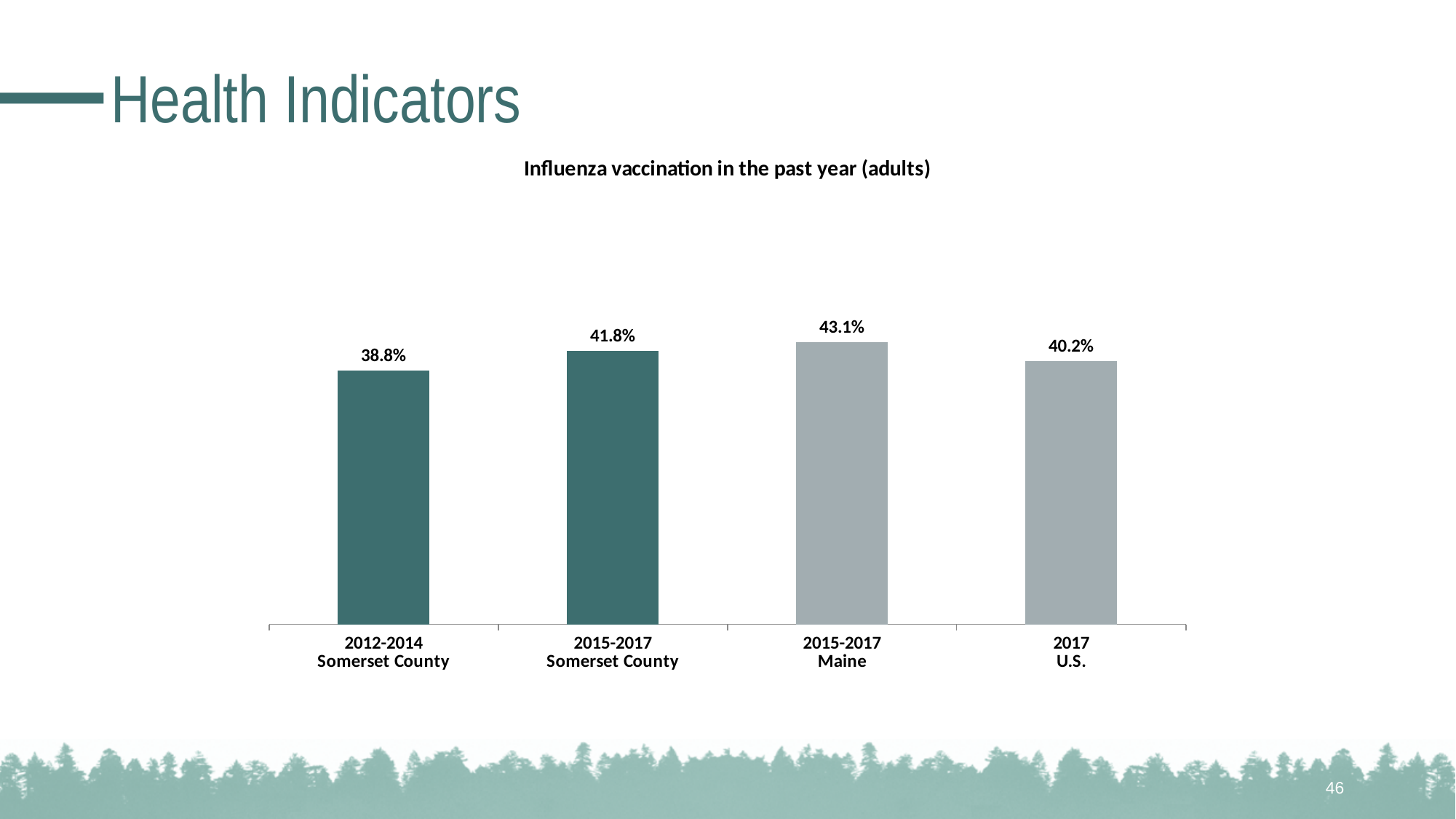
What is the difference between the Maine 2015-2017 rate and the Somerset County 2015-2017 rate? 1.3% What is the influenza vaccination rate for the U.S. in 2017? 40.2% Which category has the highest influenza vaccination rate? 2015-2017 Maine What is the influenza vaccination rate for Somerset County in 2012-2014? 38.8% What is the influenza vaccination rate for Somerset County in 2015-2017? 41.8% What kind of chart is shown on the slide? Bar chart What is the title of the chart? Influenza vaccination in the past year (adults) By how much did the Somerset County rate change from 2012-2014 to 2015-2017? 3.0% How many bars are shown in the chart? 4 What is the influenza vaccination rate for Maine in 2015-2017? 43.1% Which category has the lowest influenza vaccination rate? 2012-2014 Somerset County Which is larger, the Somerset County 2015-2017 rate or the U.S. 2017 rate? Somerset County 2015-2017